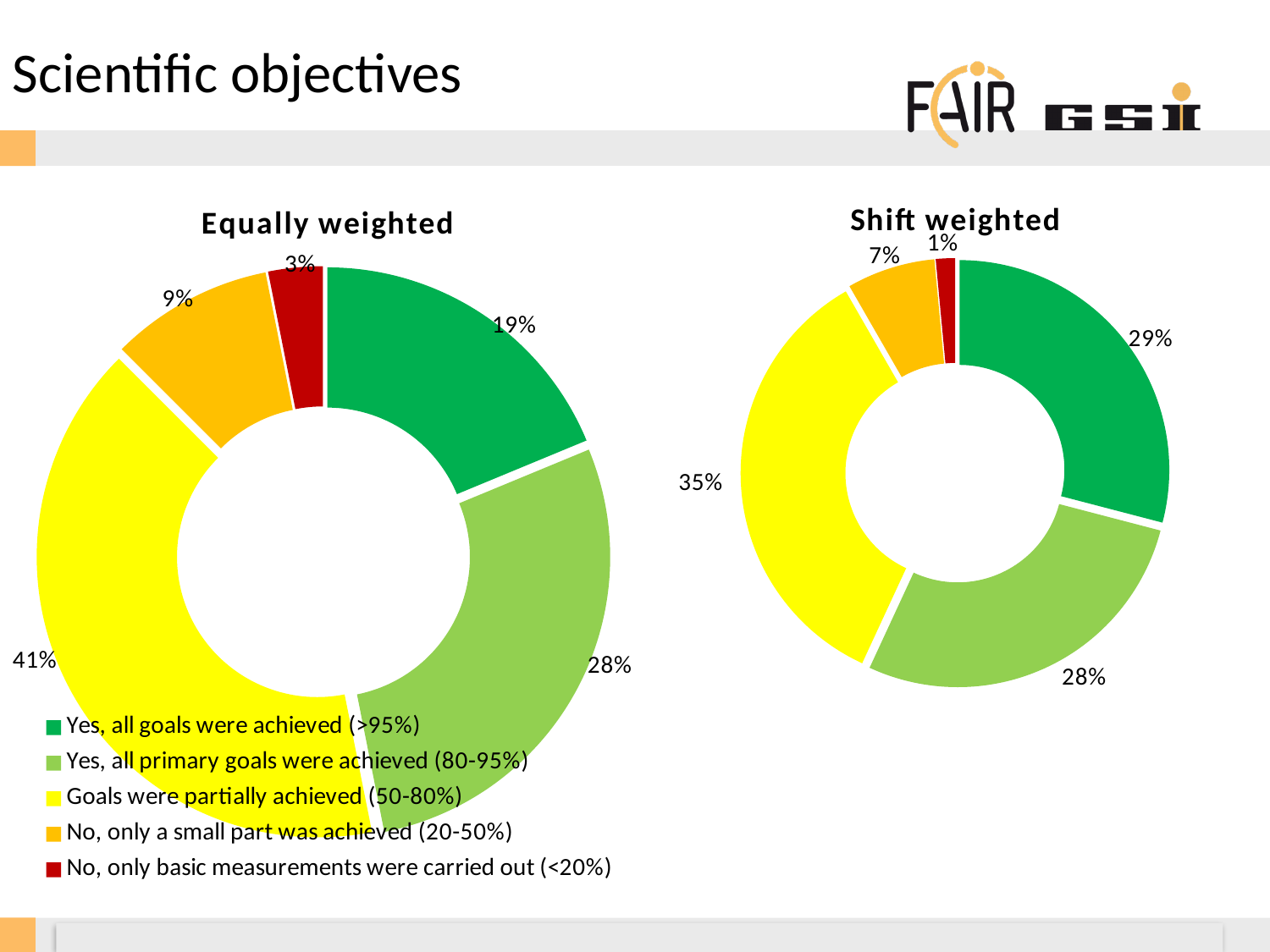
In the 'Equally weighted' chart, which category has the largest share? Goals were partially achieved (50-80%) In the 'Equally weighted' chart, which is larger: the share for 'Yes, all goals were achieved (>95%)' or for 'Yes, all primary goals were achieved (80-95%)'? Yes, all primary goals were achieved (80-95%) In the 'Equally weighted' chart, what share is shown for 'No, only basic measurements were carried out (<20%)'? 3% How many categories does the legend list? 5 What is the difference between the 'Yes, all goals were achieved (>95%)' share in the 'Shift weighted' chart and in the 'Equally weighted' chart? 10 percentage points In the 'Shift weighted' chart, what is the combined share of 'Yes, all goals were achieved (>95%)' and 'Yes, all primary goals were achieved (80-95%)'? 57% In the 'Shift weighted' chart, what share is shown for 'Yes, all goals were achieved (>95%)'? 29% Which colour represents 'No, only basic measurements were carried out (<20%)' in the charts? Red In the 'Shift weighted' chart, which category has the smallest share? No, only basic measurements were carried out (<20%) What kind of chart is the 'Shift weighted' chart? Doughnut (pie) chart In the 'Shift weighted' chart, what share is shown for 'No, only a small part was achieved (20-50%)'? 7% In the 'Equally weighted' chart, what share is shown for 'Goals were partially achieved (50-80%)'? 41%